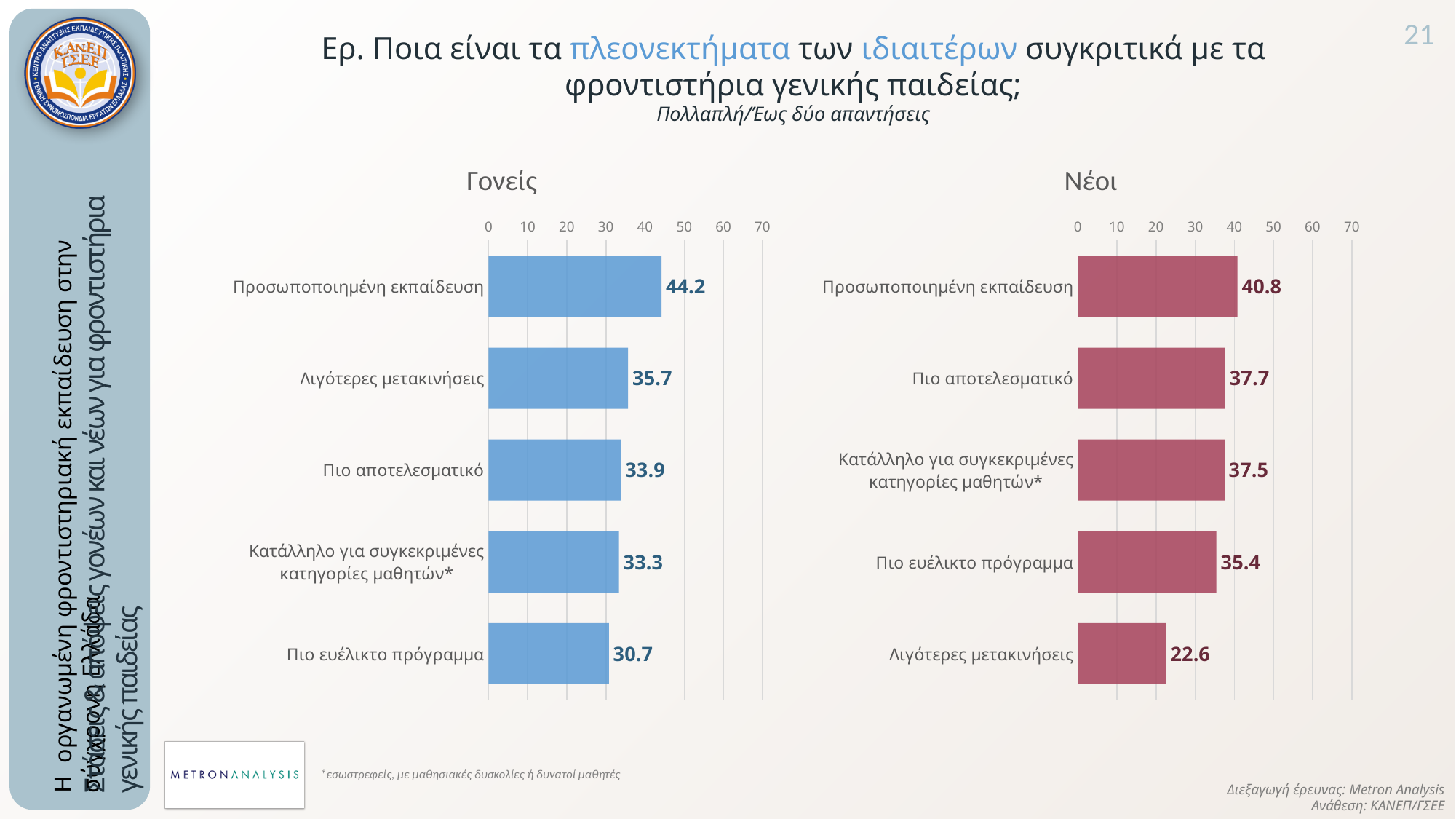
In the Νέοι chart, what is the value for Λιγότερες μετακινήσεις? 22.6 What kind of chart is the Γονείς chart? bar chart What colour are the bars in the Νέοι chart? red How many categories does the Νέοι chart show? 5 In the Γονείς chart, what is the difference between Προσωποποιημένη εκπαίδευση and Λιγότερες μετακινήσεις? 8.5 In the Νέοι chart, which category has the highest value? Προσωποποιημένη εκπαίδευση Which is larger: the value for Πιο αποτελεσματικό in the Γονείς chart or in the Νέοι chart? Νέοι In the Νέοι chart, what is the difference between Πιο αποτελεσματικό and Λιγότερες μετακινήσεις? 15.1 In the Γονείς chart, which category has the lowest value? Πιο ευέλικτο πρόγραμμα In the Νέοι chart, what is the value for Πιο ευέλικτο πρόγραμμα? 35.4 In the Γονείς chart, what is the value for Προσωποποιημένη εκπαίδευση? 44.2 In the Γονείς chart, is the value for Προσωποποιημένη εκπαίδευση greater or less than 40? greater